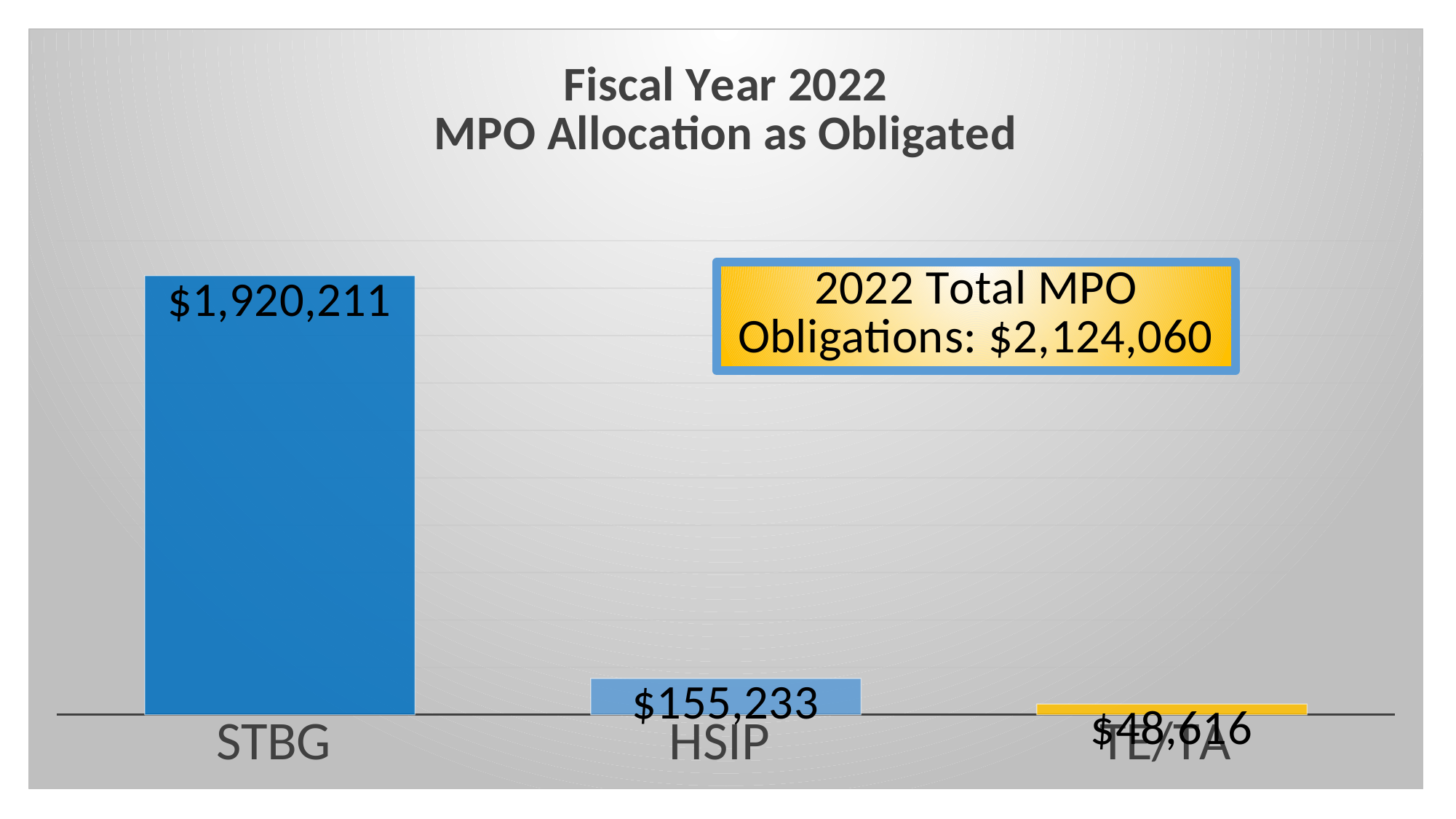
What is the title of the chart? Fiscal Year 2022 MPO Allocation as Obligated What is the total of the three values shown in the chart? $2,124,060 What is the value for STBG? $1,920,211 What kind of chart is shown on the slide? Bar chart What is the value for TE/TA? $48,616 Which is larger, the value for HSIP or the value for TE/TA? HSIP What is the difference between the HSIP and TE/TA values? $106,617 What is the difference between the STBG and HSIP values? $1,764,978 Which category has the highest value? STBG What is the value for HSIP? $155,233 How many categories are shown in the chart? 3 Which category has the lowest value? TE/TA